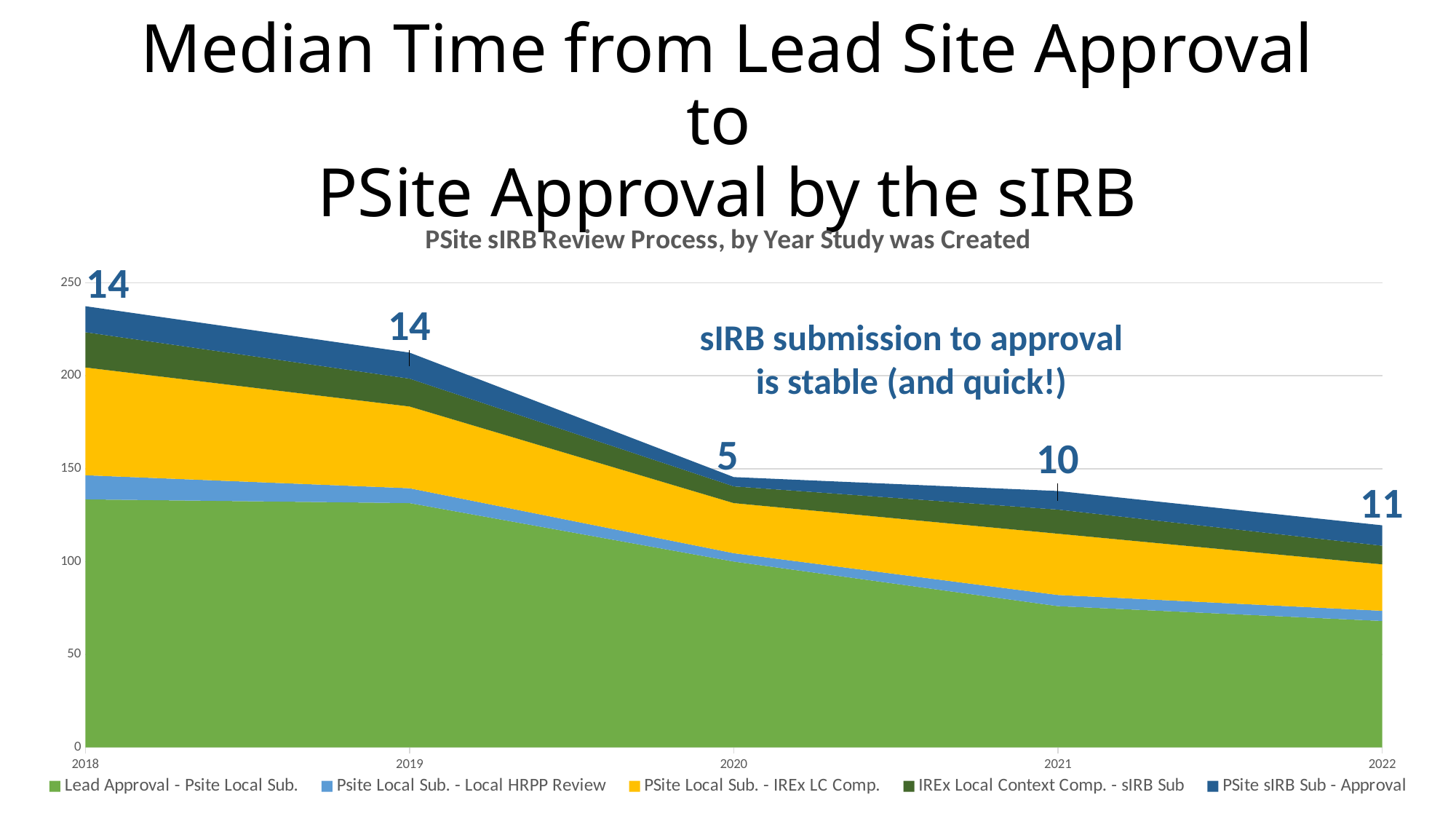
What kind of chart is shown on the slide? Stacked area chart Is the total stacked value for 2018 greater or less than 200? greater What is the labelled value for PSite sIRB Sub - Approval in 2020? 5 What is the labelled value for PSite sIRB Sub - Approval in 2021? 10 Is the total stacked value for 2022 greater or less than 150? less Which is larger, the labelled PSite sIRB Sub - Approval value for 2021 or for 2022? 2022 How many series does the legend list? 5 What is the labelled value for PSite sIRB Sub - Approval in 2022? 11 What is the labelled value for PSite sIRB Sub - Approval in 2018? 14 In which year is the labelled PSite sIRB Sub - Approval value lowest? 2020 What is the difference between the labelled PSite sIRB Sub - Approval values for 2019 and 2020? 9 How many years are shown on the x axis? 5